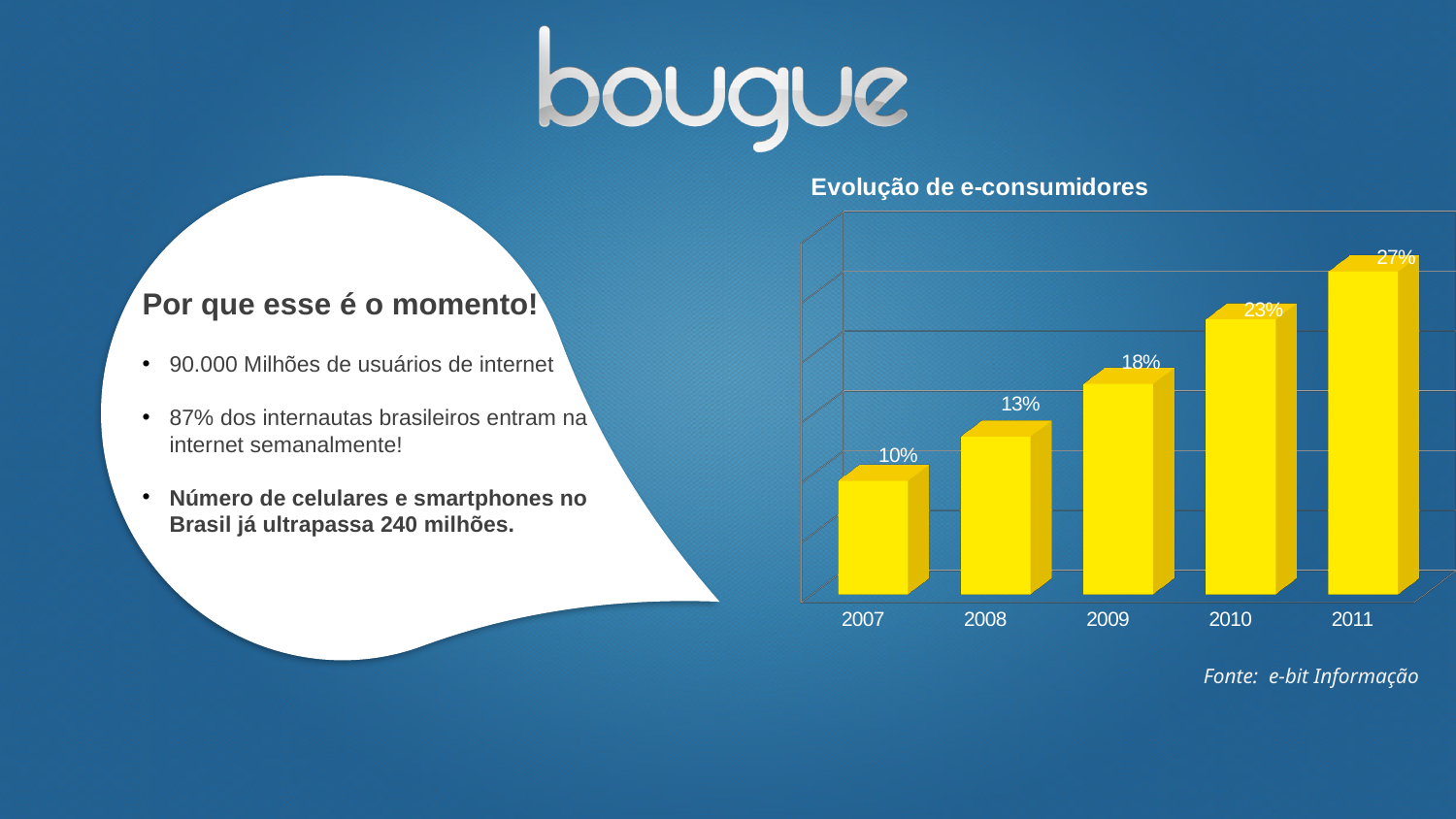
Which year has the lowest value? 2007 Which is larger, the value for 2008 or the value for 2010? 2010 What is the value for 2009? 18% What is the difference between the values for 2011 and 2007? 17% What is the difference between the values for 2010 and 2008? 10% What is the title of the chart? Evolução de e-consumidores Which year has the highest value? 2011 Do the values rise or fall from 2007 to 2011? Rise What is the value for 2007? 10% What kind of chart is this? Bar chart What is the value for 2011? 27% How many years are shown on the x axis? 5